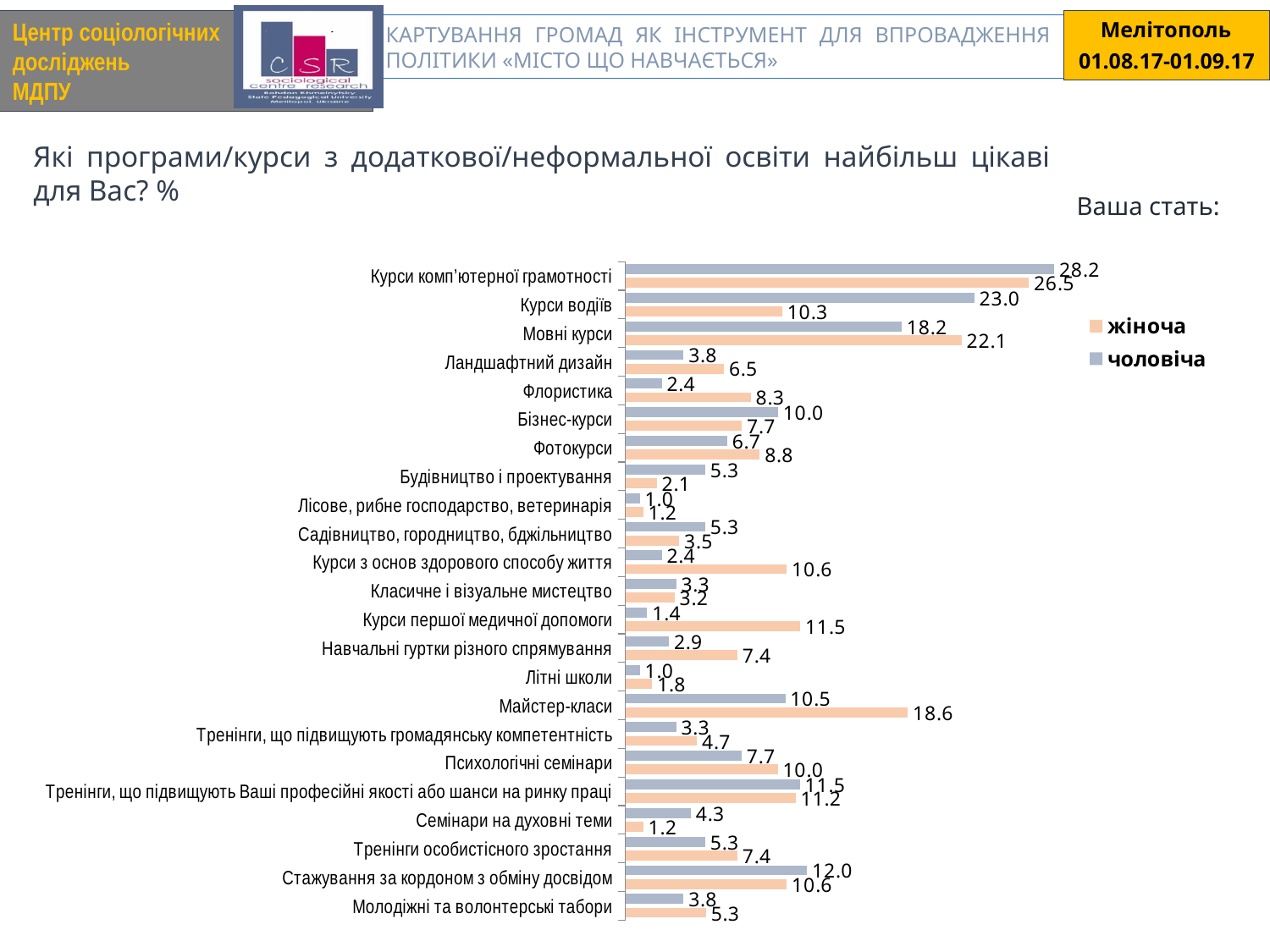
What is the value for жіноча for Майстер-класи? 18.6 What type of chart is shown on the slide? bar chart Which category has the highest value for чоловіча? Курси комп'ютерної грамотності How many series does the legend list? 2 For Стажування за кордоном з обміну досвідом, which series has the larger value, жіноча or чоловіча? чоловіча What is the difference between the чоловіча and жіноча values for Курси водіїв? 12.7 For Курси першої медичної допомоги, which series has the larger value, жіноча or чоловіча? жіноча How many categories (programs/courses) are shown in the chart? 23 Which series is shown in the orange colour in the legend? жіноча Which category has the lowest value for жіноча? Лісове, рибне господарство, ветеринарія and Семінари на духовні теми (both 1.2) What is the value for жіноча for Курси комп'ютерної грамотності? 26.5 What is the value for чоловіча for Курси водіїв? 23.0